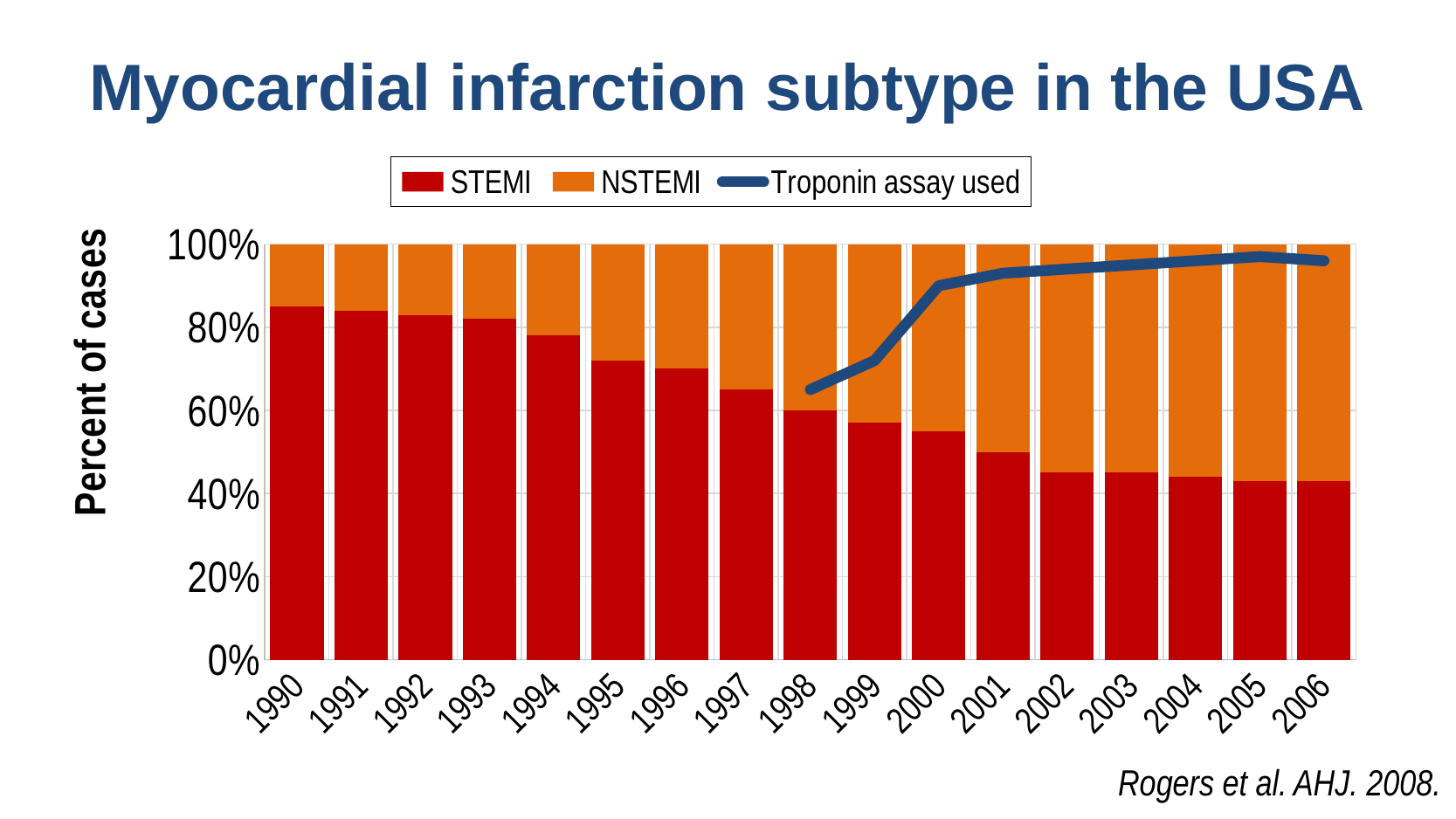
How many series does the legend list? 3 Does the 'Troponin assay used' line rise or fall from 1998 to 2005? Rise Which is larger, the STEMI share in 1990 or in 2006? 1990 Is the 'Troponin assay used' value for 1998 greater or less than 80%? less How many years are shown along the x axis? 17 Is the STEMI value for 2006 greater or less than 60%? less Does the STEMI share of cases rise or fall from 1990 to 2006? Fall What is the total height of each stacked bar (STEMI plus NSTEMI)? 100% What is the label on the y axis? Percent of cases What kind of chart is shown on the slide? Stacked bar chart with a line In which year is the STEMI share of cases highest? 1990 Is the STEMI value for 1990 greater or less than 80%? greater